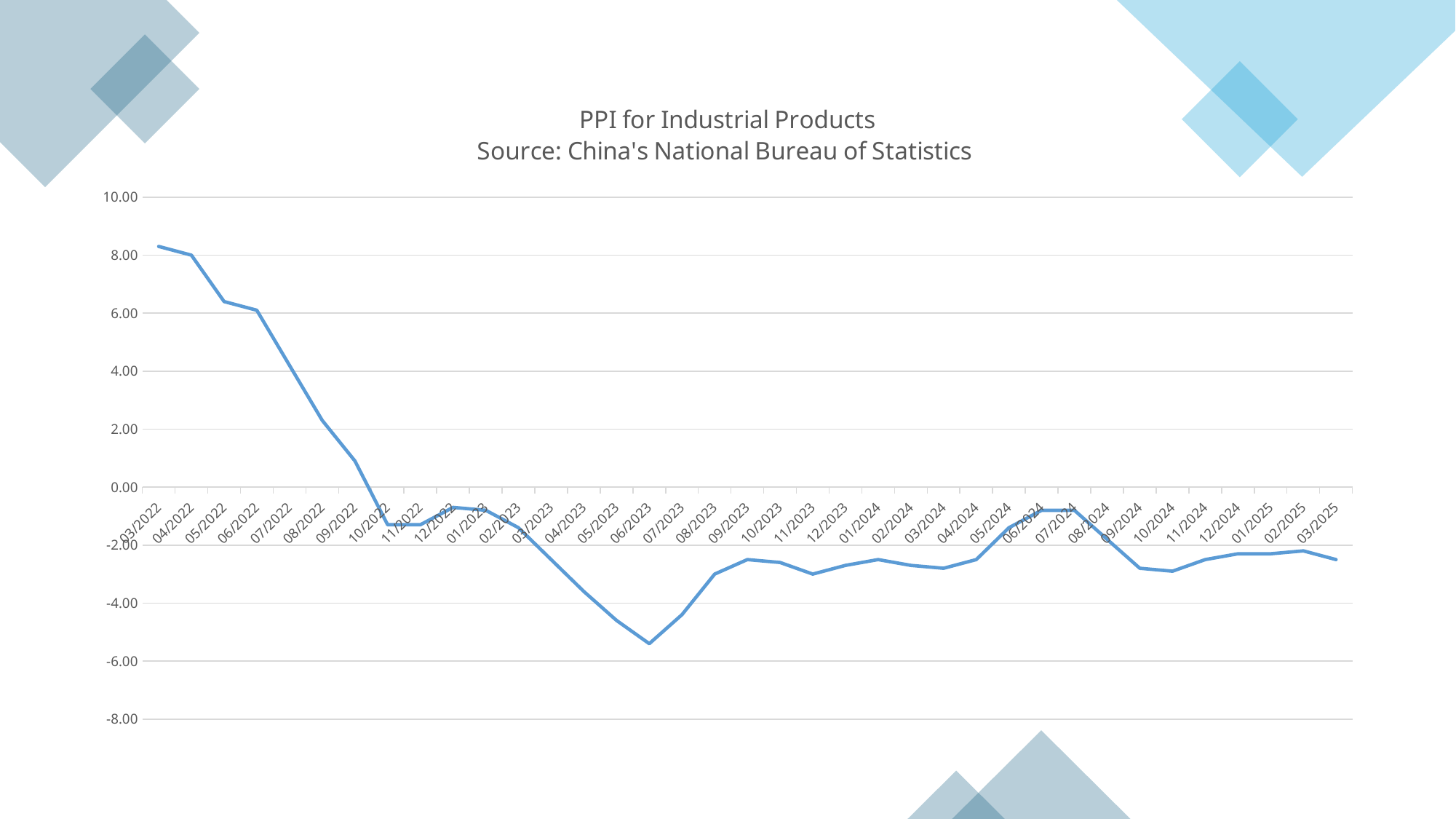
Which month has the lowest PPI value on the chart? 06/2023 According to the chart subtitle, what is the source of the data? China's National Bureau of Statistics Is the value for 06/2023 greater or less than -4.00? less Does the PPI value rise or fall from 03/2022 to 10/2022? fall How many monthly data points are plotted on the chart? 37 What kind of chart is shown on the slide? line chart Is the value for 07/2022 greater or less than 6.00? less Is the value for 03/2025 greater or less than 0.00? less Which month has the highest PPI value on the chart? 03/2022 Which has the larger PPI value, 06/2023 or 06/2024? 06/2024 What is the title of the chart? PPI for Industrial Products